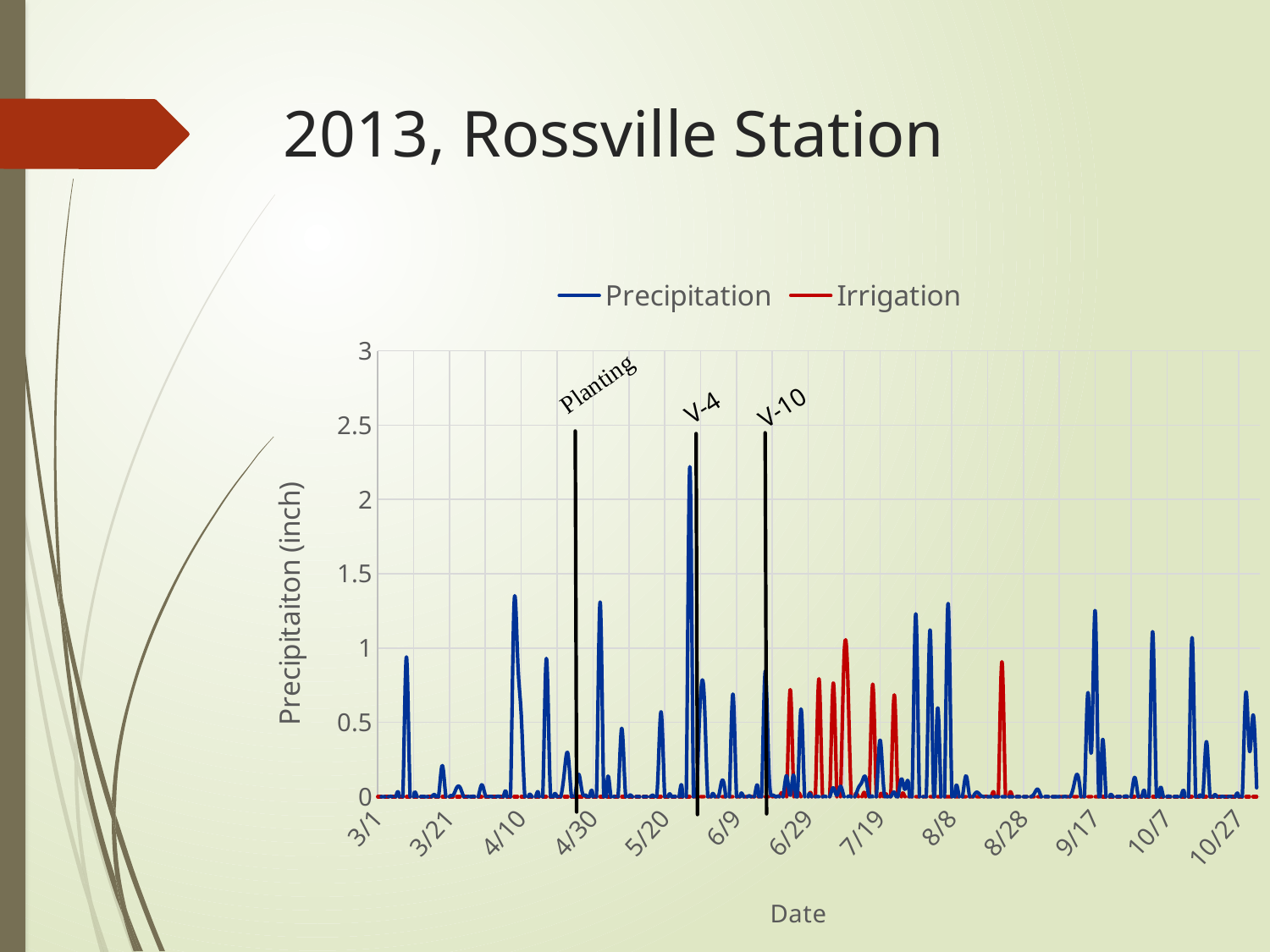
Which series reaches the highest peak on the chart, Precipitation or Irrigation? Precipitation What is the title of the slide containing the chart? 2013, Rossville Station Is the highest Irrigation peak greater or less than 0.5 inches? greater Which series is drawn in red? Irrigation Is the highest Irrigation peak greater or less than 1.5 inches? less How many labelled vertical marker lines (Planting, V-4, V-10) are drawn on the chart? 3 Is the highest Precipitation peak greater or less than 2.5 inches? less What is the maximum value shown on the y axis? 3 What kind of chart is shown on the slide? Line chart How many series does the legend list? 2